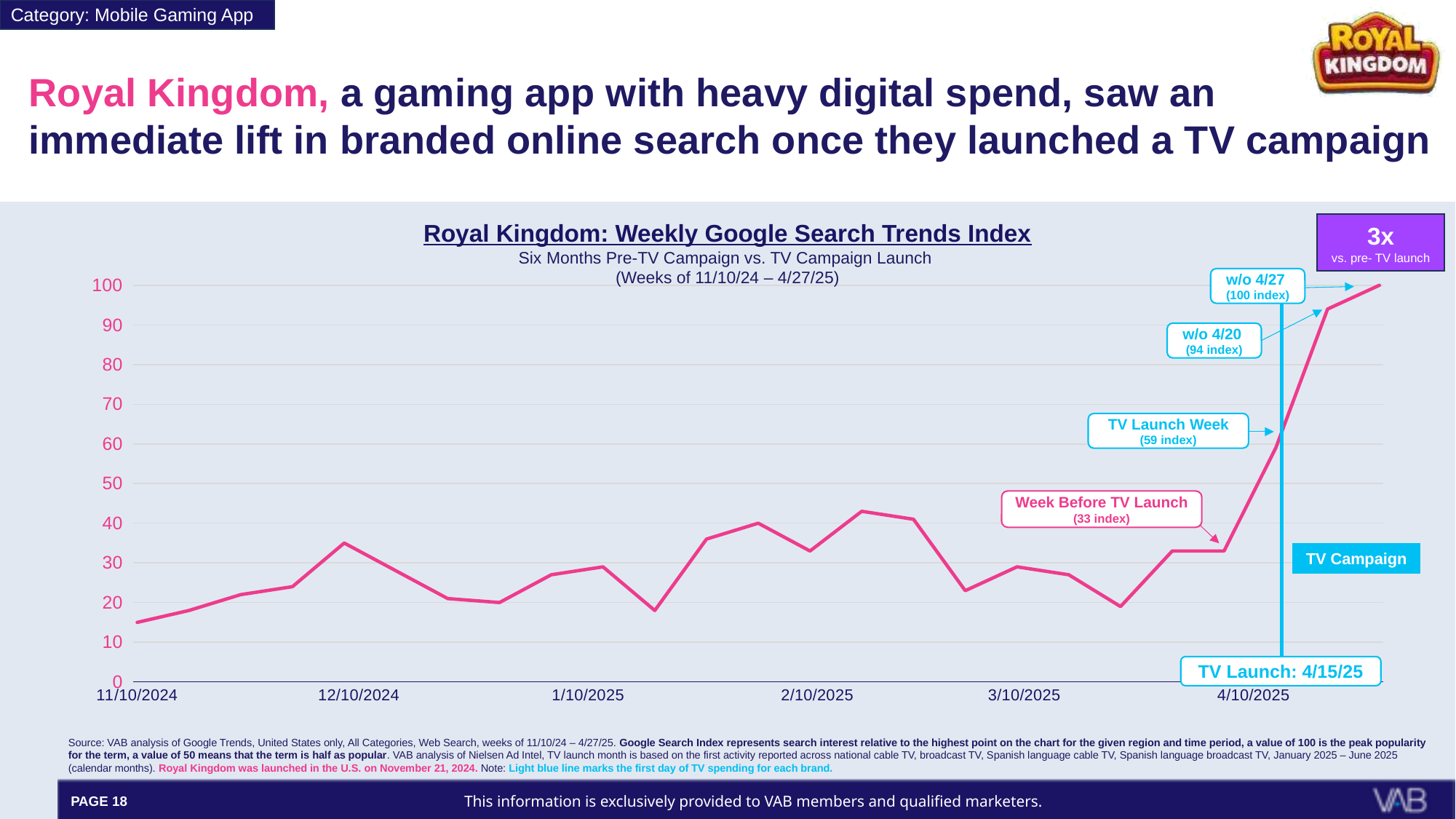
Which is larger: the index for w/o 4/20 or the index for the TV Launch Week? w/o 4/20 What was the search index during the TV Launch Week? 59 What was the Google search index for the week of 4/27 (w/o 4/27)? 100 What is the TV launch date marked on the chart? 4/15/25 What kind of chart is shown on the slide? line chart What is the difference in index between the TV Launch Week and the Week Before TV Launch? 26 Which week has the highest search index on the chart? w/o 4/27 Is the search index at 11/10/2024 greater or less than 20? less What was the search index for the week of 4/20 (w/o 4/20)? 94 Does the search index rise or fall after the TV launch on 4/15/25? rise What was the search index in the Week Before TV Launch? 33 By how many index points did the search index rise from the Week Before TV Launch to the week of 4/27? 67